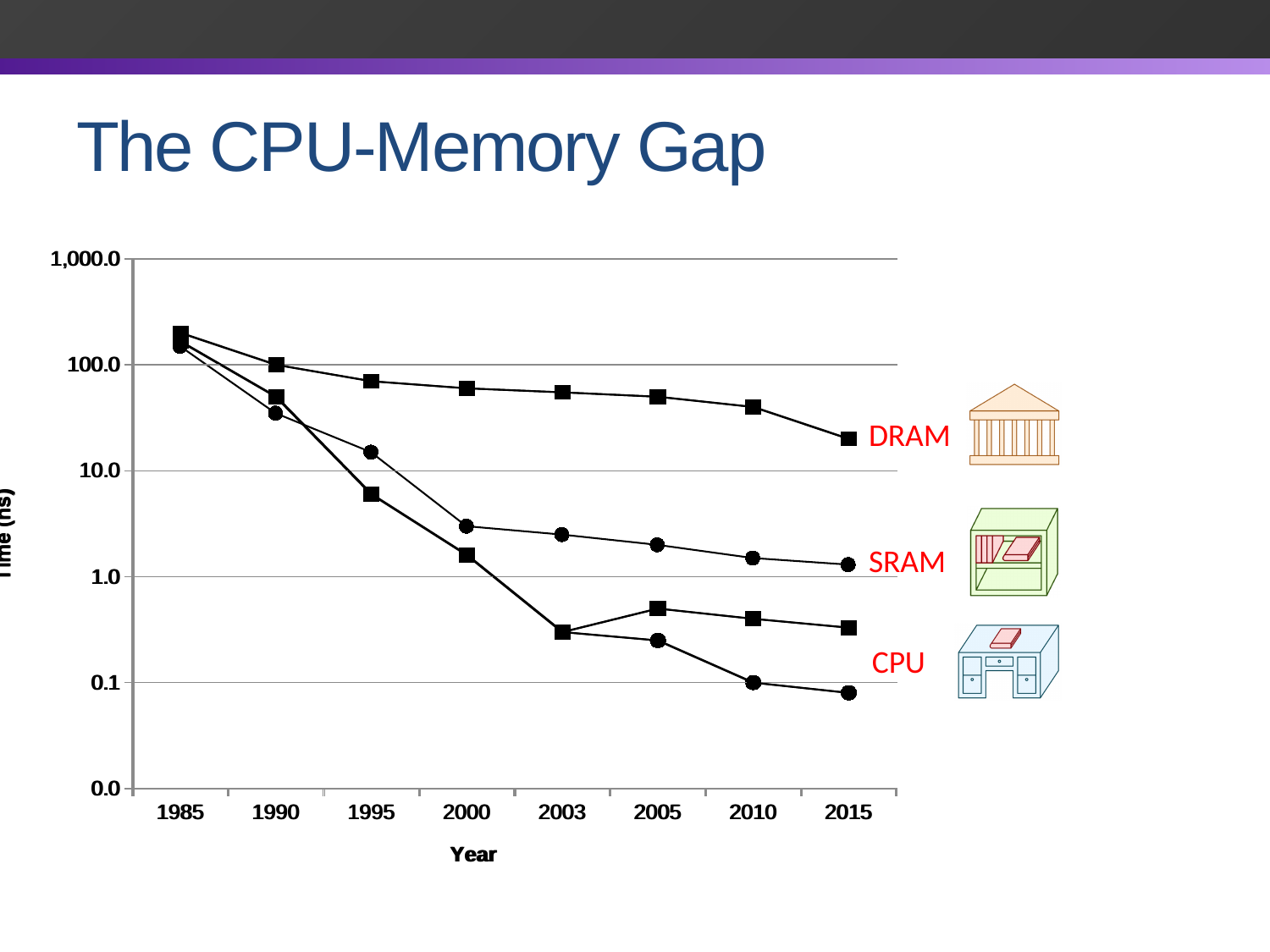
What is the title of the x axis of the chart? Year Is the SRAM value in 2015 greater or less than 10.0? less Does the SRAM line rise or fall from 1985 to 2015? fall Does the DRAM line rise or fall from 1985 to 2015? fall How many years are marked along the x axis of the chart? 8 Which labelled line has the highest value in 2015? DRAM In 2015, which is larger, the DRAM value or the SRAM value? DRAM Is the DRAM value in 1985 greater or less than 100.0? greater Is the SRAM value in 2000 greater or less than 10.0? less Which three lines are labelled on the chart? DRAM, SRAM, CPU What kind of chart is shown on the slide? line chart